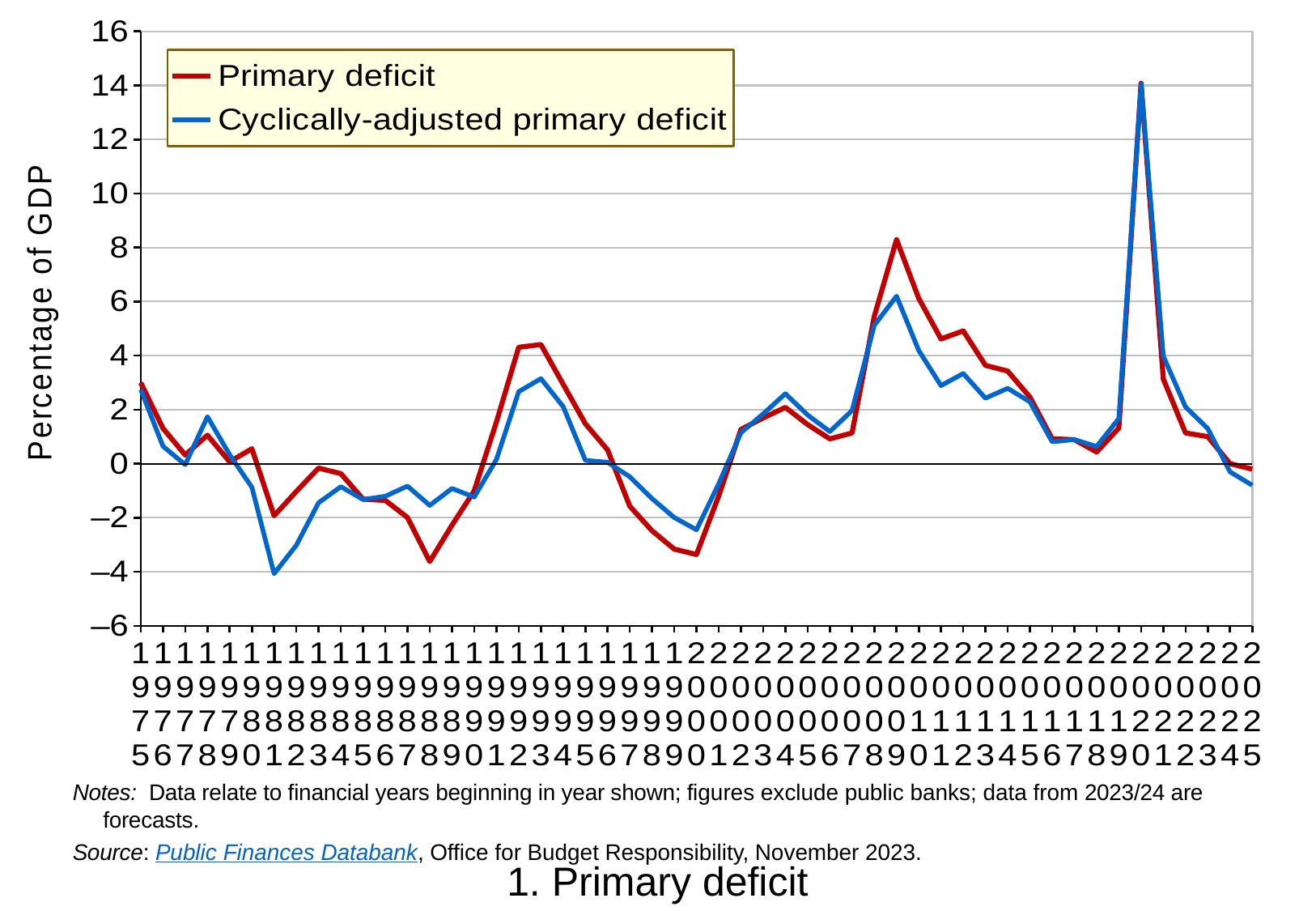
What is the title of the chart? 1. Primary deficit What kind of chart is shown on the slide? line chart In 2009, which series has the higher value, Primary deficit or Cyclically-adjusted primary deficit? Primary deficit Is the Primary deficit value for 2009 greater or less than 6? greater Is the Primary deficit value for 2020 greater or less than 10? greater How many series does the legend list? 2 What is the label on the vertical axis? Percentage of GDP In which year does the Primary deficit series reach its highest value? 2020 In which year does the Cyclically-adjusted primary deficit series reach its lowest value? 1981 Does the Primary deficit series rise or fall between 2009 and 2012? fall Is the Cyclically-adjusted primary deficit value for 1981 greater or less than -2? less In 1978, which series has the higher value, Primary deficit or Cyclically-adjusted primary deficit? Cyclically-adjusted primary deficit